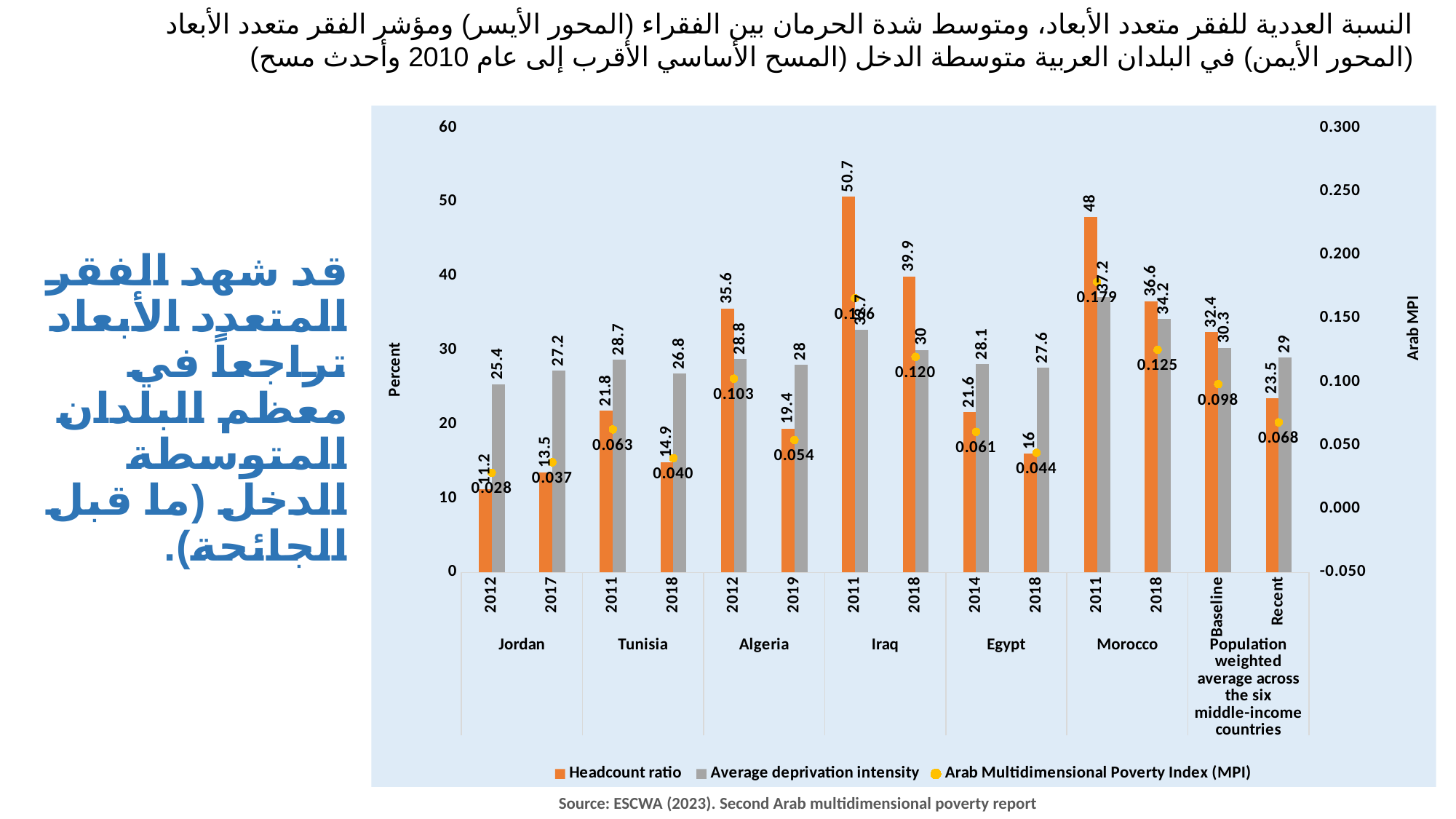
What kind of chart is shown on the slide? Bar chart with MPI points plotted on a secondary axis Which country and year has the lowest headcount ratio? Jordan 2012 Which is larger, the headcount ratio for Algeria in 2012 or for Egypt in 2014? Algeria 2012 What is the headcount ratio for Jordan in 2017? 13.5 What is the average deprivation intensity for Tunisia in 2018? 26.8 Which country and year has the highest headcount ratio? Iraq 2011 What is the Arab Multidimensional Poverty Index (MPI) value for Morocco in 2011? 0.179 Did Jordan's headcount ratio rise or fall from 2012 to 2017? Rise What is the MPI value for the population weighted average across the six middle-income countries in the recent survey? 0.068 How many series does the legend list? 3 By how much did Morocco's headcount ratio fall between 2011 and 2018? 11.4 Is the headcount ratio for Iraq in 2018 greater or less than 30? greater